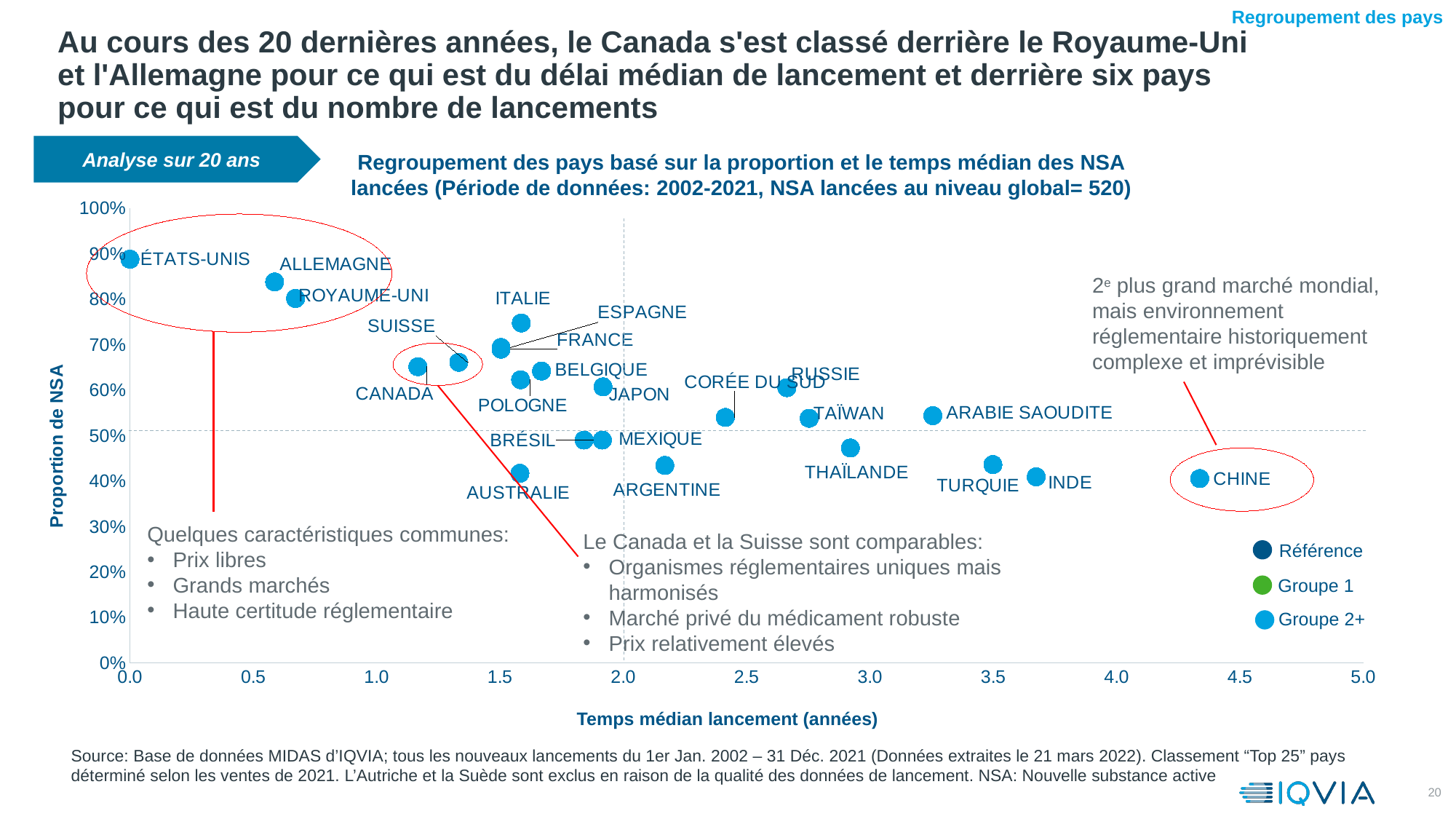
Is the proportion of NSA for ITALIE greater or less than 70%? greater Which country has the highest proportion of NSA (Proportion de NSA)? ÉTATS-UNIS Which has a higher proportion of NSA, ALLEMAGNE or ROYAUME-UNI? ALLEMAGNE How many countries are plotted on the chart? 23 Which country has the longest median launch time (Temps médian lancement)? CHINE Which country has the shortest median launch time (Temps médian lancement)? ÉTATS-UNIS Is the median launch time for CHINE greater or less than 4.0 years? greater Is the proportion of NSA for AUSTRALIE greater or less than 50%? less Which has a longer median launch time, CANADA or CHINE? CHINE What kind of chart is shown on the slide? Scatter chart How many entries does the legend list? 3 What is the title of the x axis of the chart? Temps médian lancement (années)